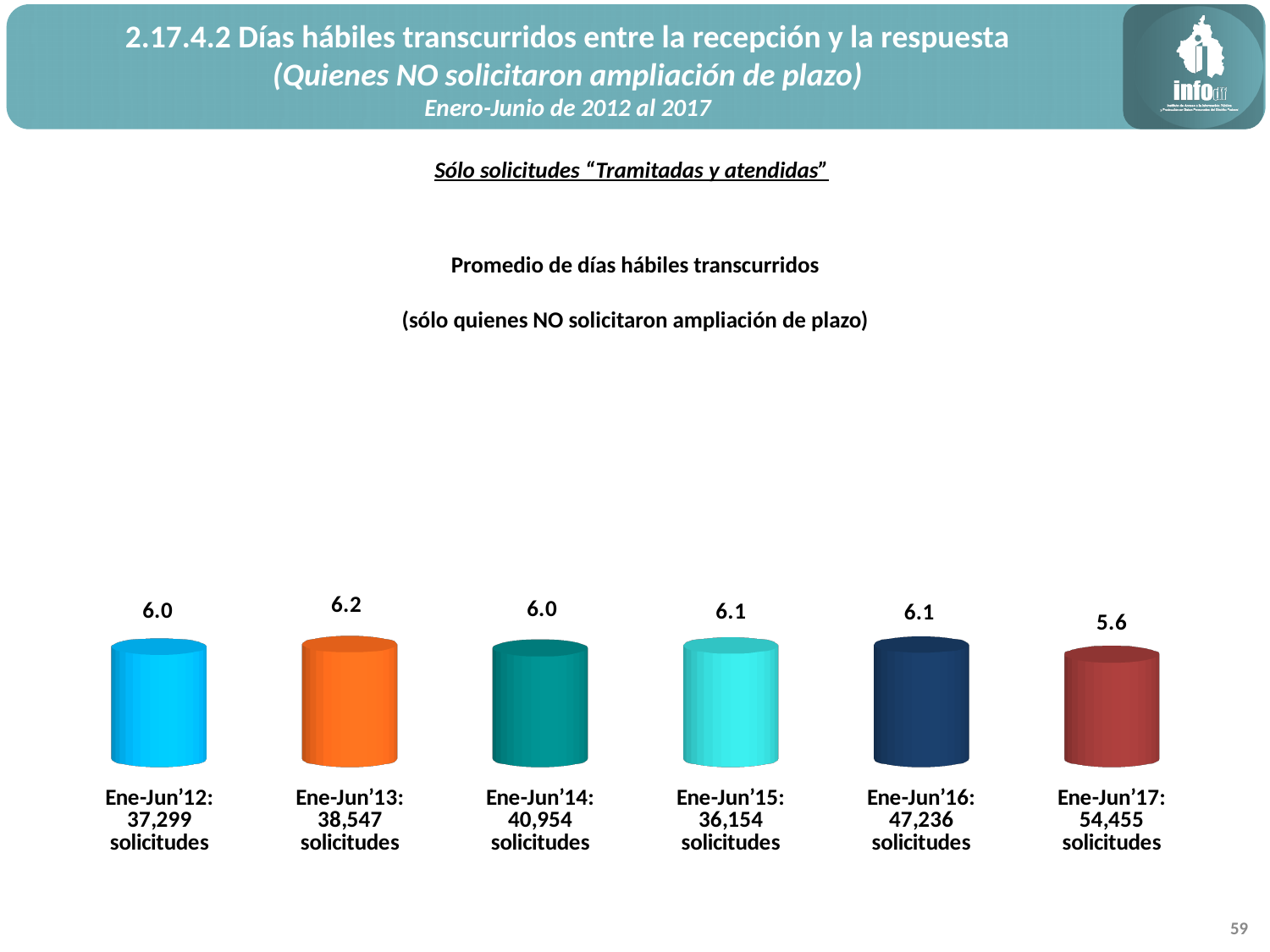
Which period has the highest average number of business days? Ene-Jun'13 What is the average number of business days for Ene-Jun'12? 6.0 Which is larger, the average for Ene-Jun'16 or Ene-Jun'17? Ene-Jun'16 What kind of chart is shown on the slide? Bar chart What is the difference between the average for Ene-Jun'13 and Ene-Jun'17? 0.6 How many solicitudes are reported for Ene-Jun'16? 47,236 What is the average number of business days for Ene-Jun'13? 6.2 Which period has the lowest average number of business days? Ene-Jun'17 How many periods are shown in the chart? 6 What is the title of the chart? Promedio de días hábiles transcurridos (sólo quienes NO solicitaron ampliación de plazo) What is the average number of business days for Ene-Jun'15? 6.1 What is the average number of business days for Ene-Jun'17? 5.6